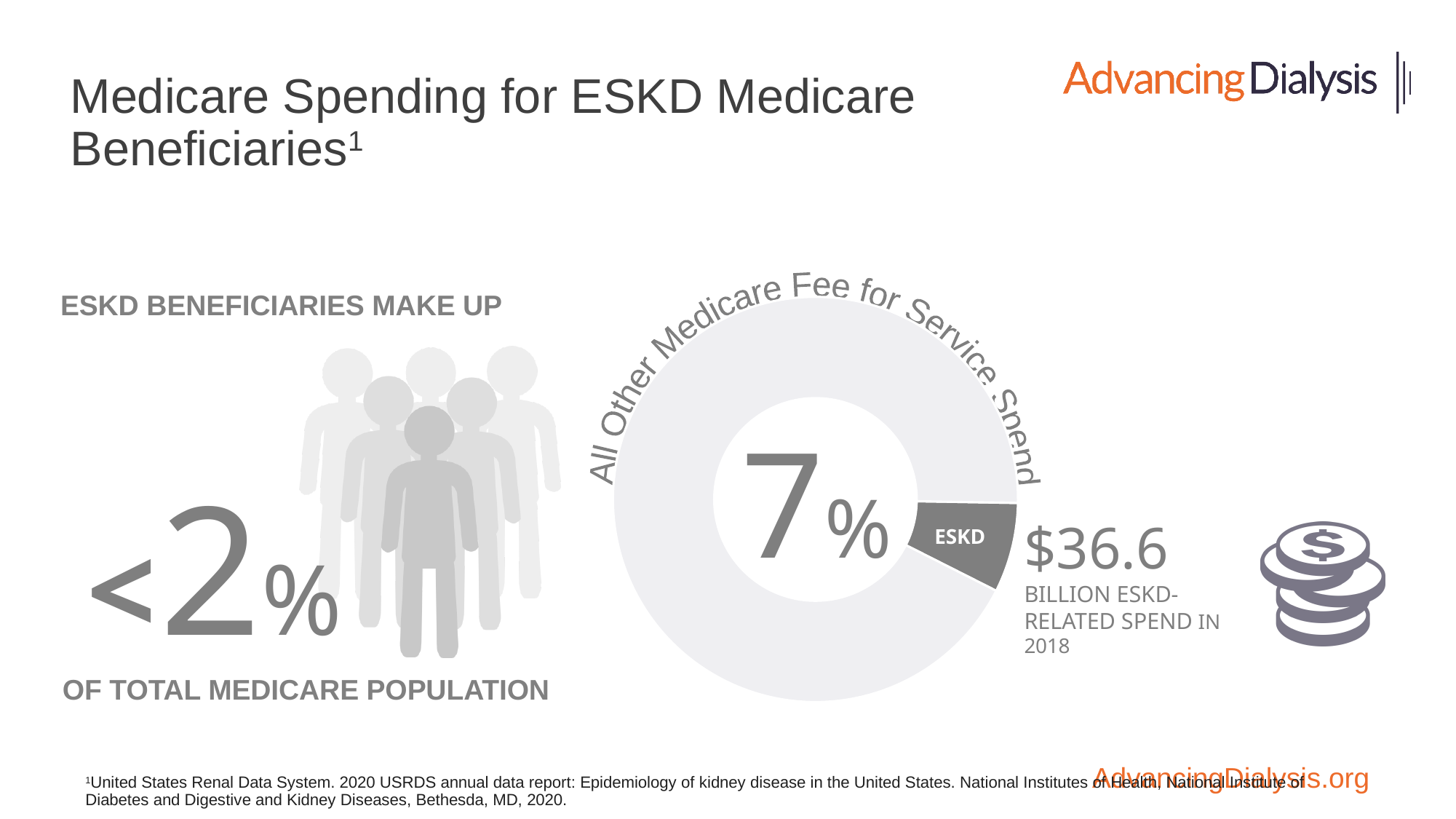
What is the label of the darker slice in the pie chart? ESKD How many slices does the pie chart have? 2 What share of Medicare fee-for-service spend does the ESKD slice represent? 7% Which slice is larger, ESKD or All Other Medicare Fee for Service Spend? All Other Medicare Fee for Service Spend What dollar amount of ESKD-related spend in 2018 is shown next to the pie chart? $36.6 billion Which slice of the pie chart is the largest? All Other Medicare Fee for Service Spend What kind of chart is shown on the slide? doughnut chart Which slice of the pie chart is the smallest? ESKD